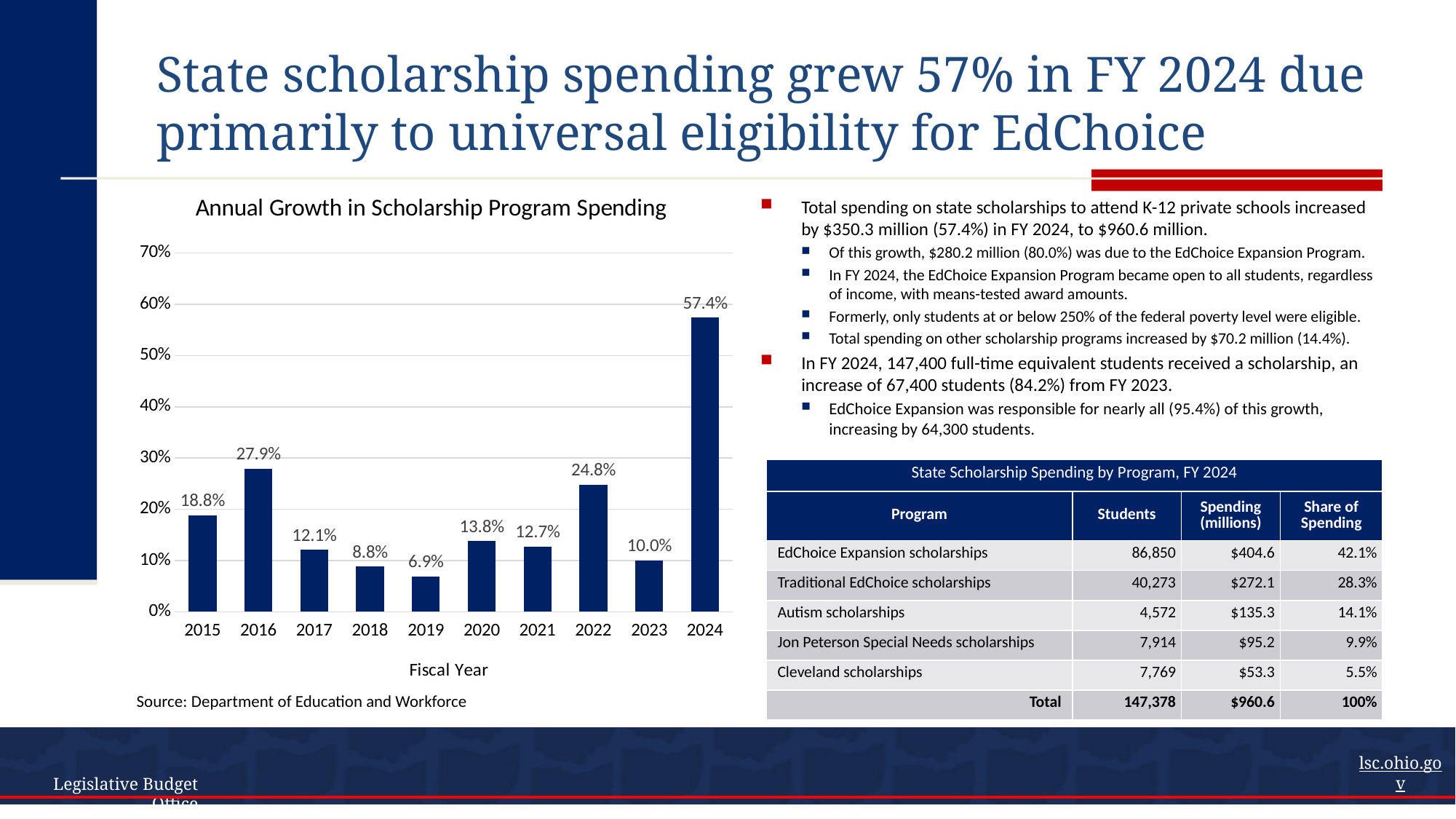
What is the annual growth in scholarship program spending for fiscal year 2016? 27.9% Which fiscal year has the lowest annual growth in scholarship program spending? 2019 What type of chart is used to show annual growth in scholarship program spending? Bar chart Is the annual growth for fiscal year 2022 greater or less than 20%? greater Which fiscal year had higher annual growth in scholarship program spending, 2022 or 2016? 2016 What is the annual growth in scholarship program spending for fiscal year 2019? 6.9% Which fiscal year has the highest annual growth in scholarship program spending? 2024 What is the difference in annual growth between fiscal year 2024 and fiscal year 2023? 47.4 percentage points What is the title of the chart on the slide? Annual Growth in Scholarship Program Spending How many fiscal years are shown on the x axis of the chart? 10 What is the annual growth in scholarship program spending for fiscal year 2024? 57.4% Did annual growth in scholarship program spending rise or fall from fiscal year 2016 to fiscal year 2019? Fall